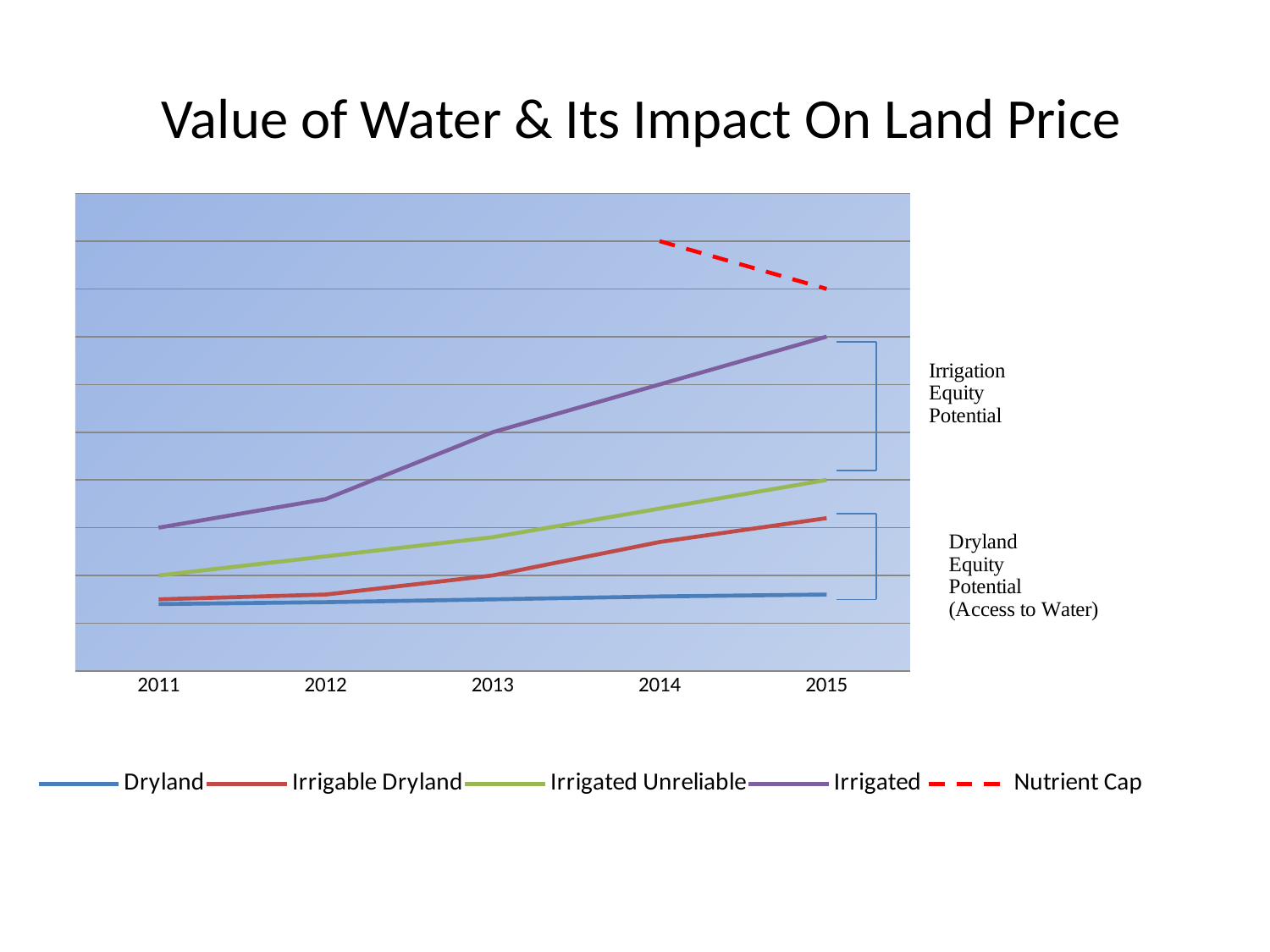
Which series has the highest value in 2015 among the solid lines? Irrigated Does the Irrigated series rise or fall from 2011 to 2015? Rise What is the title of the chart? Value of Water & Its Impact On Land Price In 2015, which is higher: Irrigated Unreliable or Irrigable Dryland? Irrigated Unreliable Which year is the first on the x axis? 2011 What kind of chart is shown on the slide? Line chart Does the Nutrient Cap series rise or fall from 2014 to 2015? Fall Which series has the lowest value in 2015? Dryland How many series does the legend list? 5 In 2013, which is higher: Irrigated or Irrigated Unreliable? Irrigated Which series is drawn as a dashed line? Nutrient Cap How many years are shown on the x axis? 5